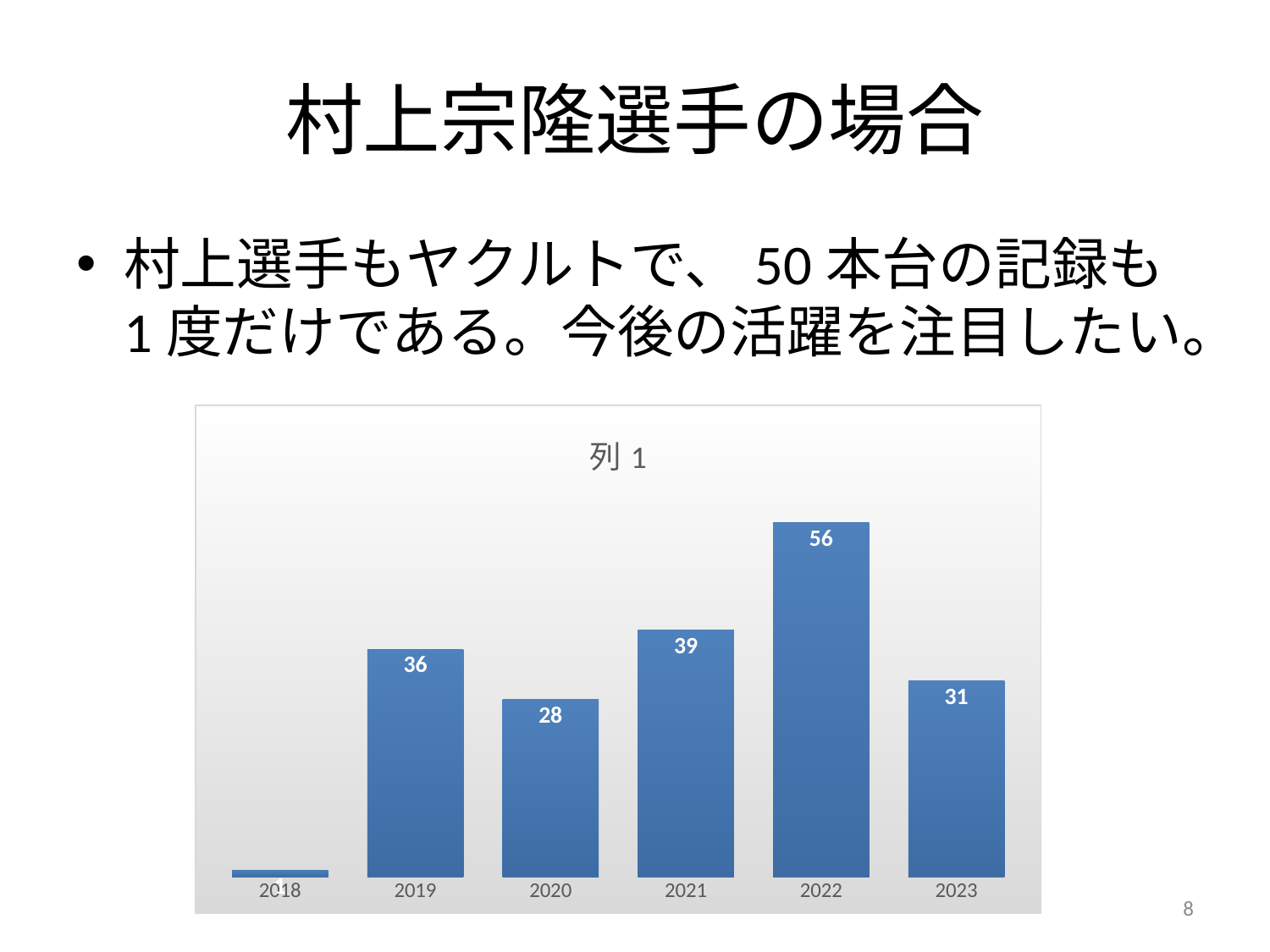
Which is larger, the value for 2019 or the value for 2023? 2019 What kind of chart is shown on the slide? Bar chart What is the title of the chart? 列 1 How many years are shown on the x axis? 6 What is the value for 2021? 39 Which year has the highest value? 2022 What is the difference between the values for 2022 and 2021? 17 What is the value for 2020? 28 Which year has the lowest value? 2018 What is the value for 2022? 56 What is the value for 2023? 31 What is the value for 2019? 36